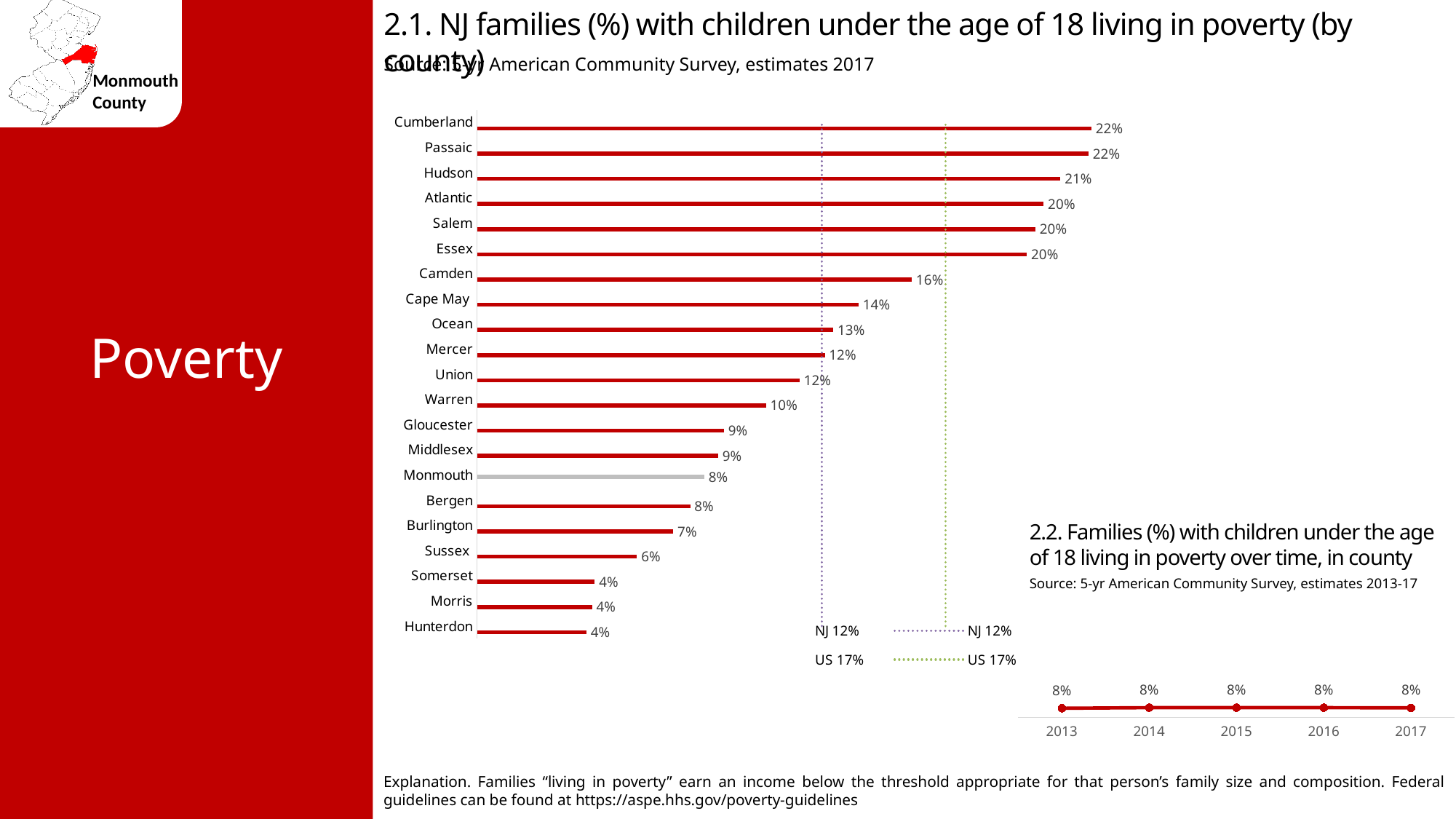
In chart 2.2, how many years are plotted? 5 In chart 2.2, do the values rise, fall, or stay flat from 2013 to 2017? Stay flat In chart 2.1, which is larger, the value for Camden or the value for Cape May? Camden In chart 2.1, what is the value shown for Hunterdon? 4% In chart 2.1, how many counties are plotted? 21 In chart 2.1, what is the NJ reference value marked by the dotted line? 12% In chart 2.1, what percentage of families with children under 18 live in poverty in Monmouth County? 8% In chart 2.1, what is the difference in percentage points between Cumberland (22%) and Monmouth (8%)? 14 percentage points In chart 2.2, what is the value for 2017? 8% In chart 2.1, which county's bar is coloured grey instead of red? Monmouth In chart 2.1, what is the value shown for Camden? 16% What kind of chart is chart 2.1? Bar chart